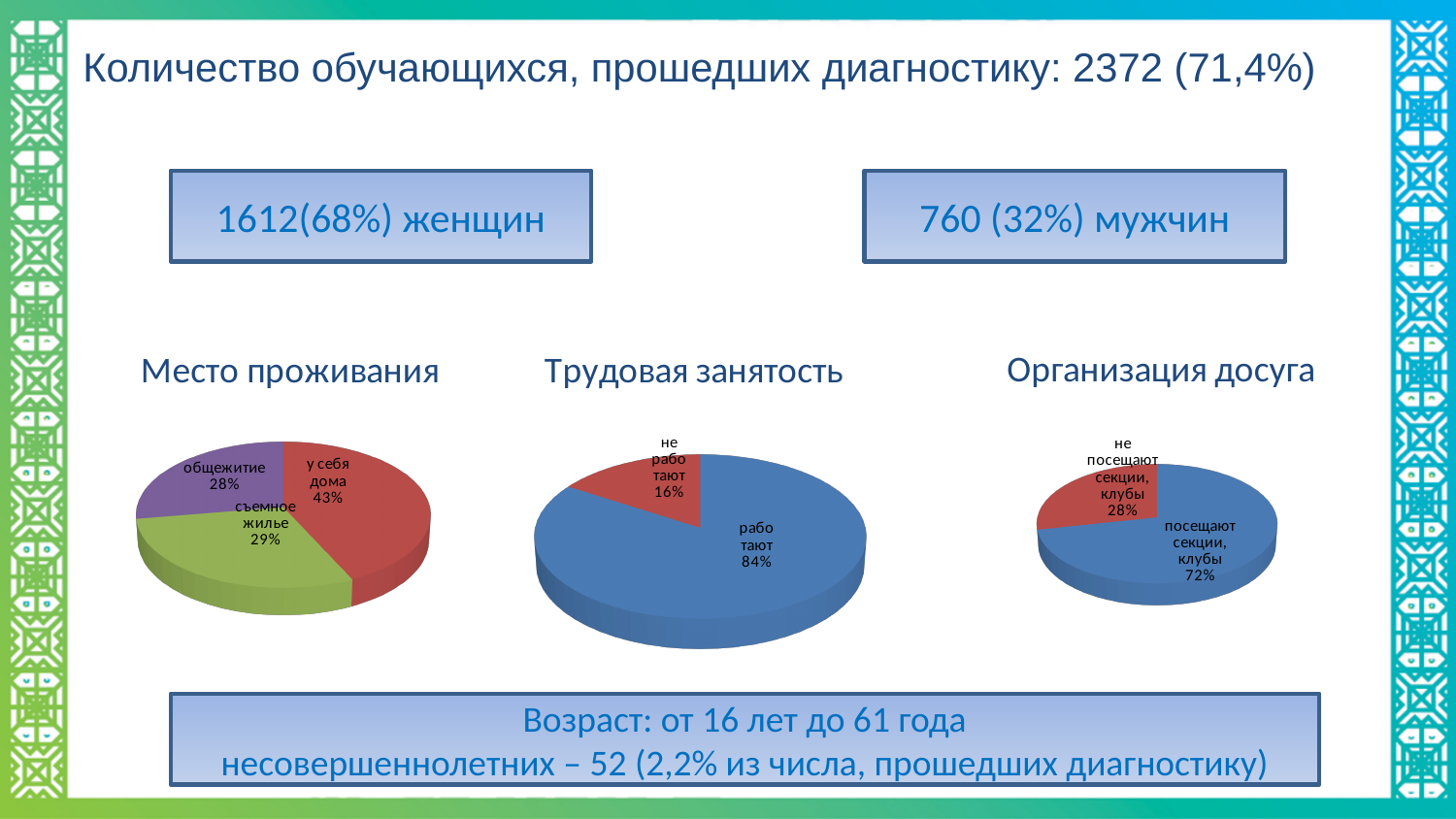
In the 'Организация досуга' chart, what share is labelled 'посещают секции, клубы'? 72% In the 'Место проживания' chart, what share is labelled 'у себя дома'? 43% In the 'Трудовая занятость' chart, which is larger: 'работают' or 'не работают'? работают In the 'Место проживания' chart, which category has the largest share? у себя дома In the 'Место проживания' chart, how many slices does the pie have? 3 In the 'Трудовая занятость' chart, what share is labelled 'работают'? 84% In the 'Место проживания' chart, what is the difference between the 'у себя дома' share and the 'общежитие' share? 15% In the 'Организация досуга' chart, what is the difference between 'посещают секции, клубы' and 'не посещают секции, клубы'? 44% In the 'Трудовая занятость' chart, what share is labelled 'не работают'? 16% In the 'Место проживания' chart, what share is labelled 'съемное жилье'? 29% How many pie charts are shown on the slide? 3 What type of chart is used for 'Организация досуга'? pie chart